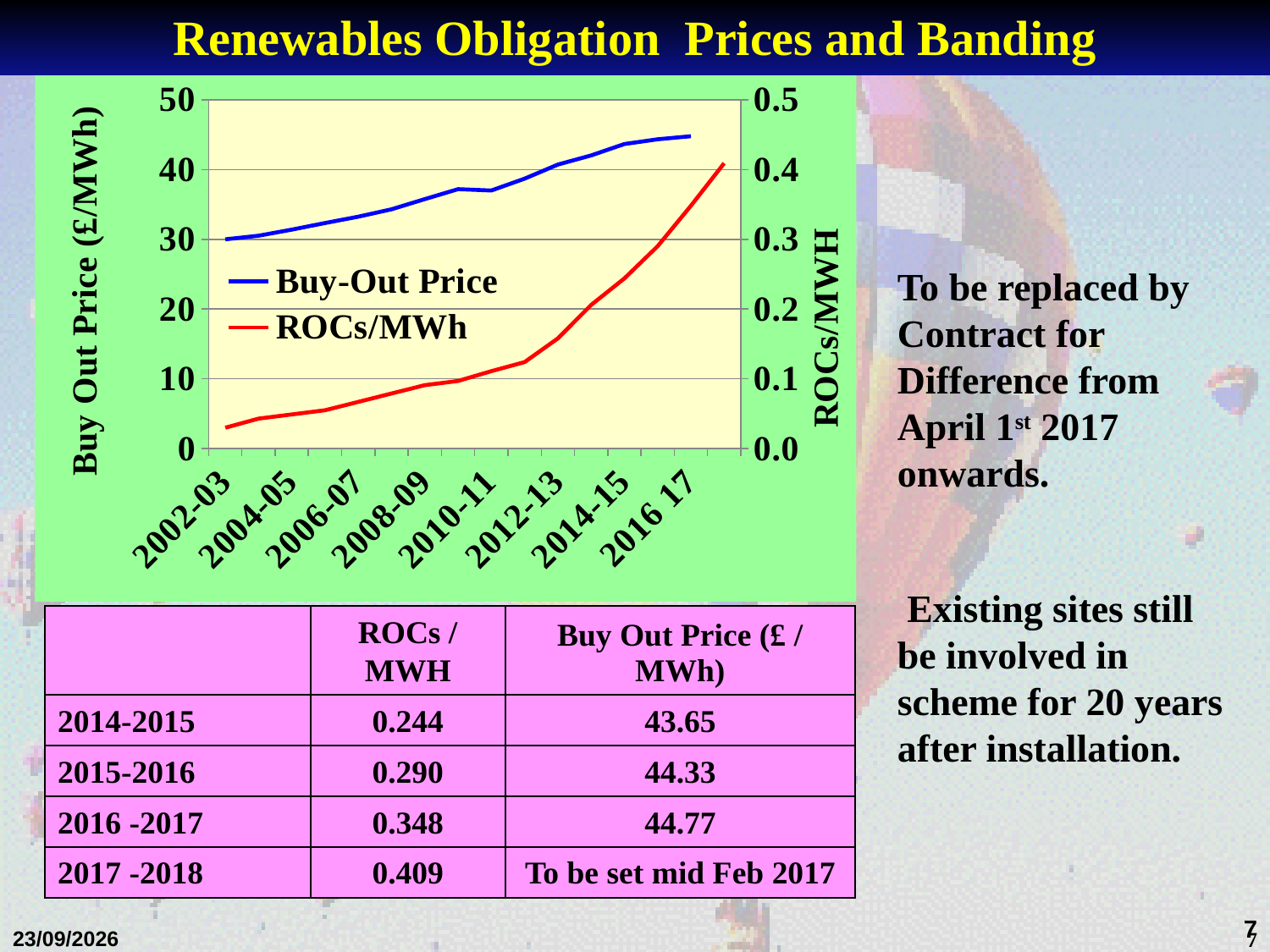
What kind of chart is shown on the slide? Line chart Does the Buy-Out Price rise or fall from 2002-03 to 2016 17? Rise Is the ROCs/MWh value for 2002-03 greater or less than 0.1? less Is the ROCs/MWh value for 2014-15 greater or less than 0.3? less What colour is the ROCs/MWh line in the chart? Red Does the ROCs/MWh series rise or fall across the years shown? Rise What is the title of the left vertical axis of the chart? Buy Out Price (£/MWh) How many series does the chart legend list? 2 Is the Buy-Out Price for 2010-11 greater or less than 40? less